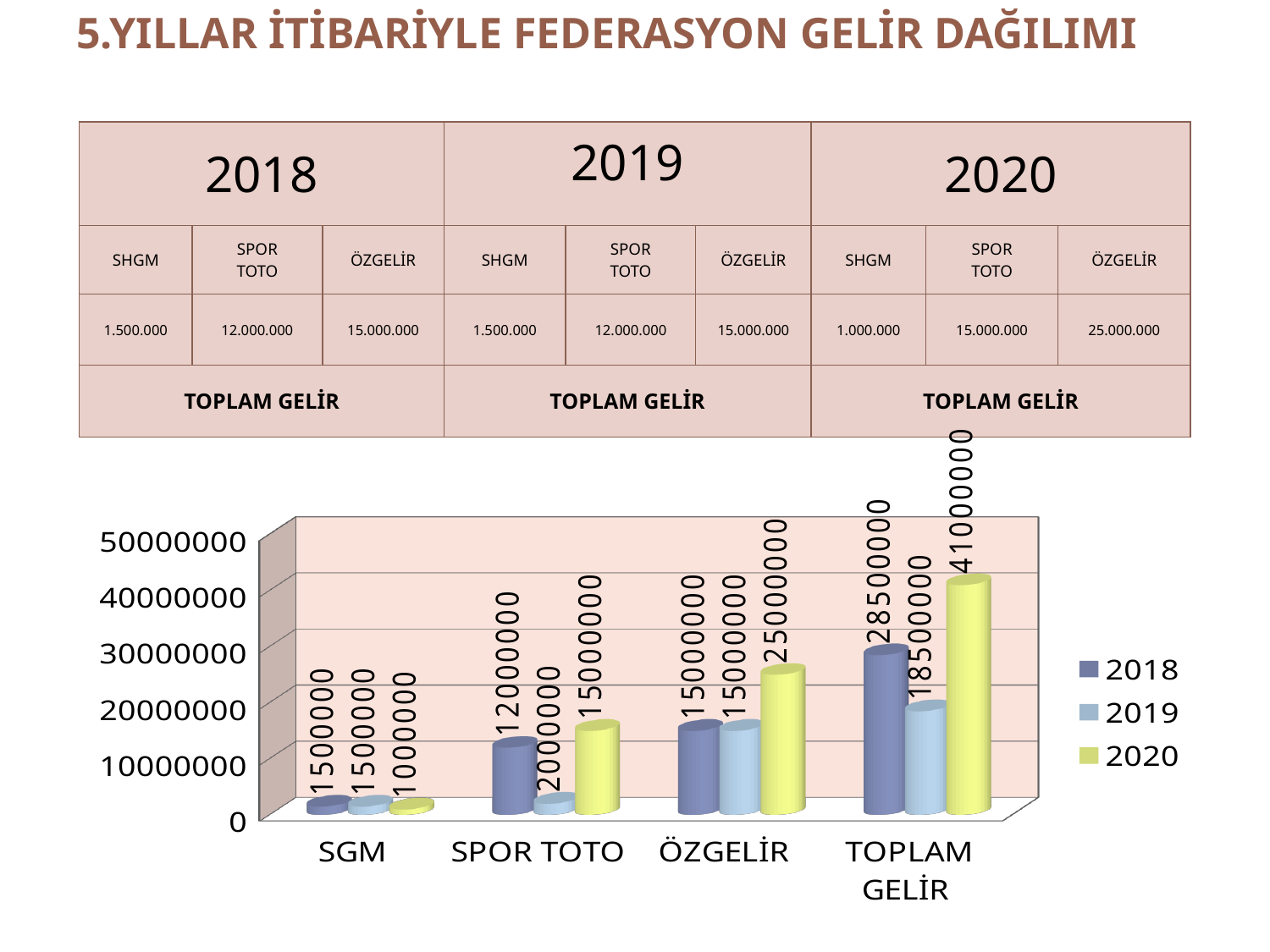
Which year has the lowest value in the SPOR TOTO category? 2019 What is the value for 2018 in the SPOR TOTO category? 12000000 Which is larger: the 2020 value for ÖZGELİR or the 2020 value for SPOR TOTO? ÖZGELİR How many categories are shown on the x axis of the chart? 4 What is the value for 2020 in the SGM category? 1000000 Which year has the highest value in the TOPLAM GELİR category? 2020 What is the value for 2020 in the TOPLAM GELİR category? 41000000 What kind of chart is shown on the slide? bar chart Which series is shown in yellow-green in the chart? 2020 What is the difference between the 2020 and 2018 values in the TOPLAM GELİR category? 12500000 How many series does the chart legend list? 3 What is the value for 2019 in the ÖZGELİR category? 15000000